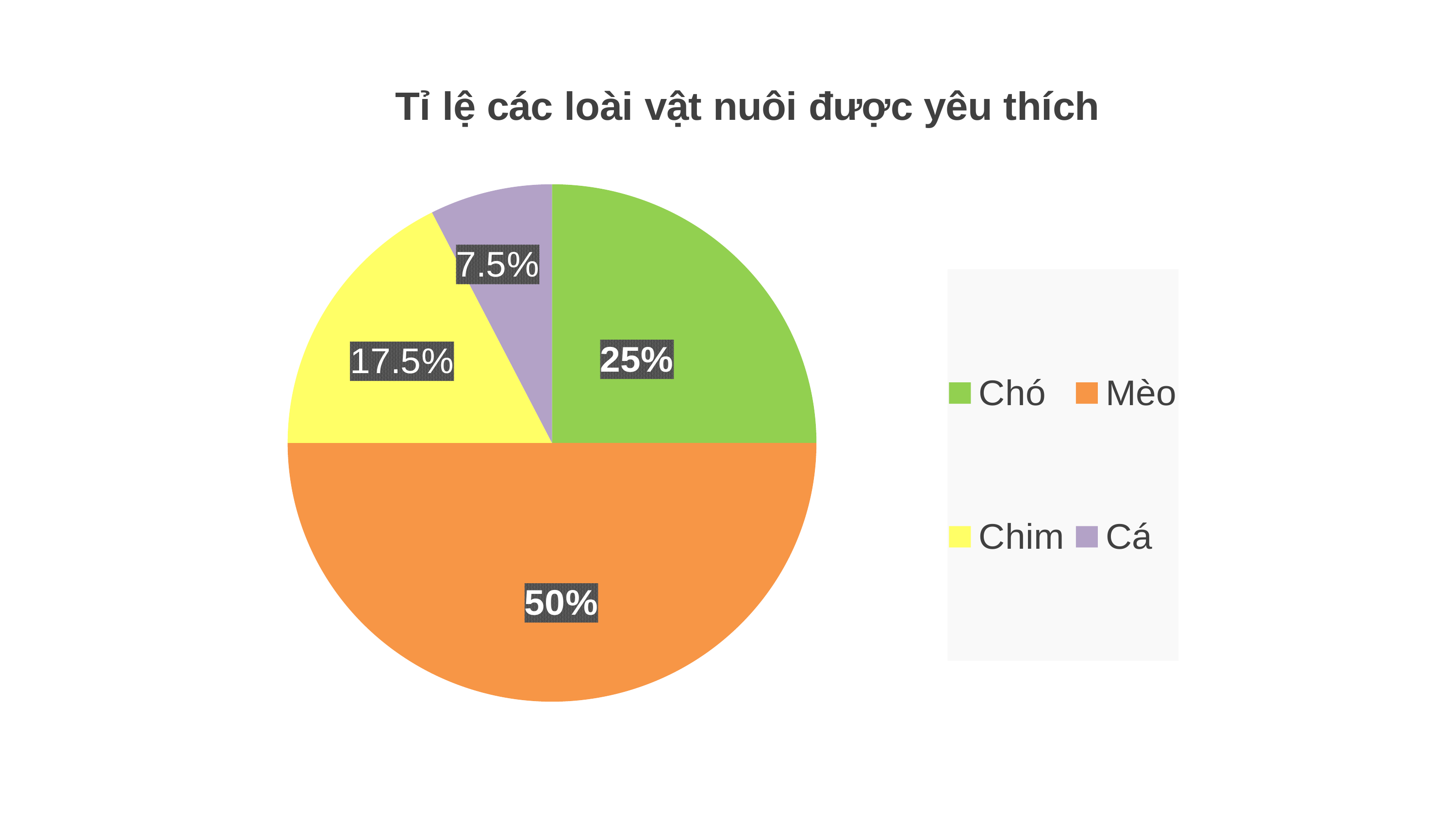
What kind of chart is shown on the slide? Pie chart Which category has the largest share of the pie? Mèo What percentage of the pie is Chim? 17.5% Which category has the smallest share of the pie? Cá What is the difference in percentage points between Mèo and Chó? 25 What percentage of the pie is Mèo? 50% What is the difference in percentage points between Chim and Cá? 10 What percentage of the pie is Chó? 25% Which is larger, the share for Chim or the share for Cá? Chim What is the title of the chart? Tỉ lệ các loài vật nuôi được yêu thích How many categories does the legend list? 4 What percentage of the pie is Cá? 7.5%